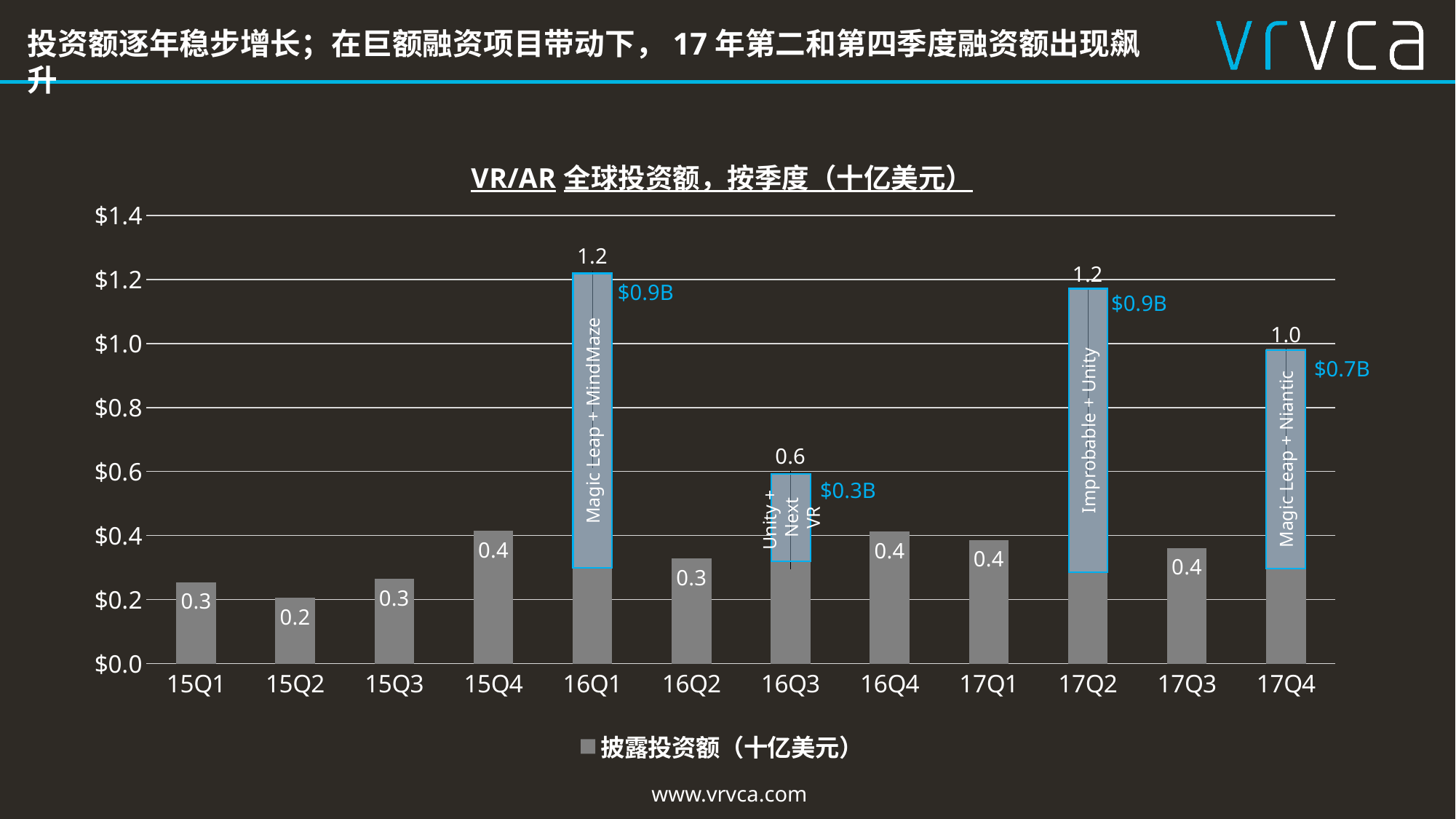
What is the value for 16Q1? 1.2 What is the value for 15Q2? 0.2 What is the value for 17Q4? 1.0 Which deal annotation is attached to the 17Q2 bar? Improbable + Unity How many quarters are shown on the x axis? 12 Is the value for 16Q2 greater or less than $0.4? less What is the value for 16Q3? 0.6 Which quarter has the lowest investment value? 15Q2 What type of chart is shown on the slide? bar chart Which is larger, the value for 17Q4 or the value for 16Q3? 17Q4 What is the difference between the values for 17Q4 and 16Q3? 0.4 How many series does the legend list? 1